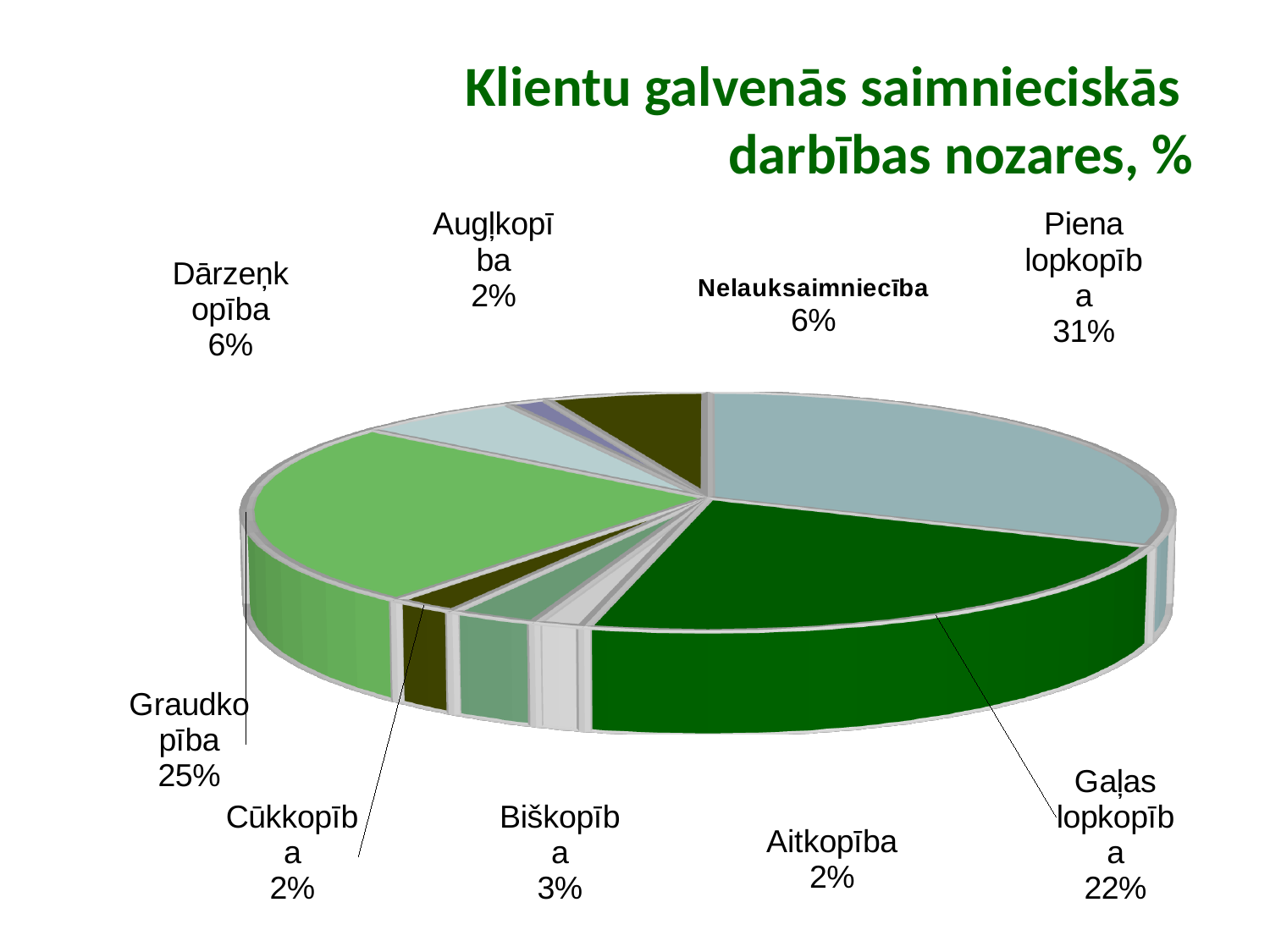
What is the title of the chart? Klientu galvenās saimnieciskās darbības nozares, % What type of chart is shown on the slide? pie chart What is the difference in percentage points between Piena lopkopība and Gaļas lopkopība? 9 Which category has the largest share in the pie chart? Piena lopkopība Which is larger, the share of Graudkopība or the share of Gaļas lopkopība? Graudkopība What share does Gaļas lopkopība have in the pie chart? 22% What share does Piena lopkopība have in the pie chart? 31% What share does Biškopība have in the pie chart? 3% What share does Graudkopība have in the pie chart? 25% What is the difference in percentage points between Dārzeņkopība and Augļkopība? 4 What share does Nelauksaimniecība have in the pie chart? 6% How many categories (slices) does the pie chart have? 9